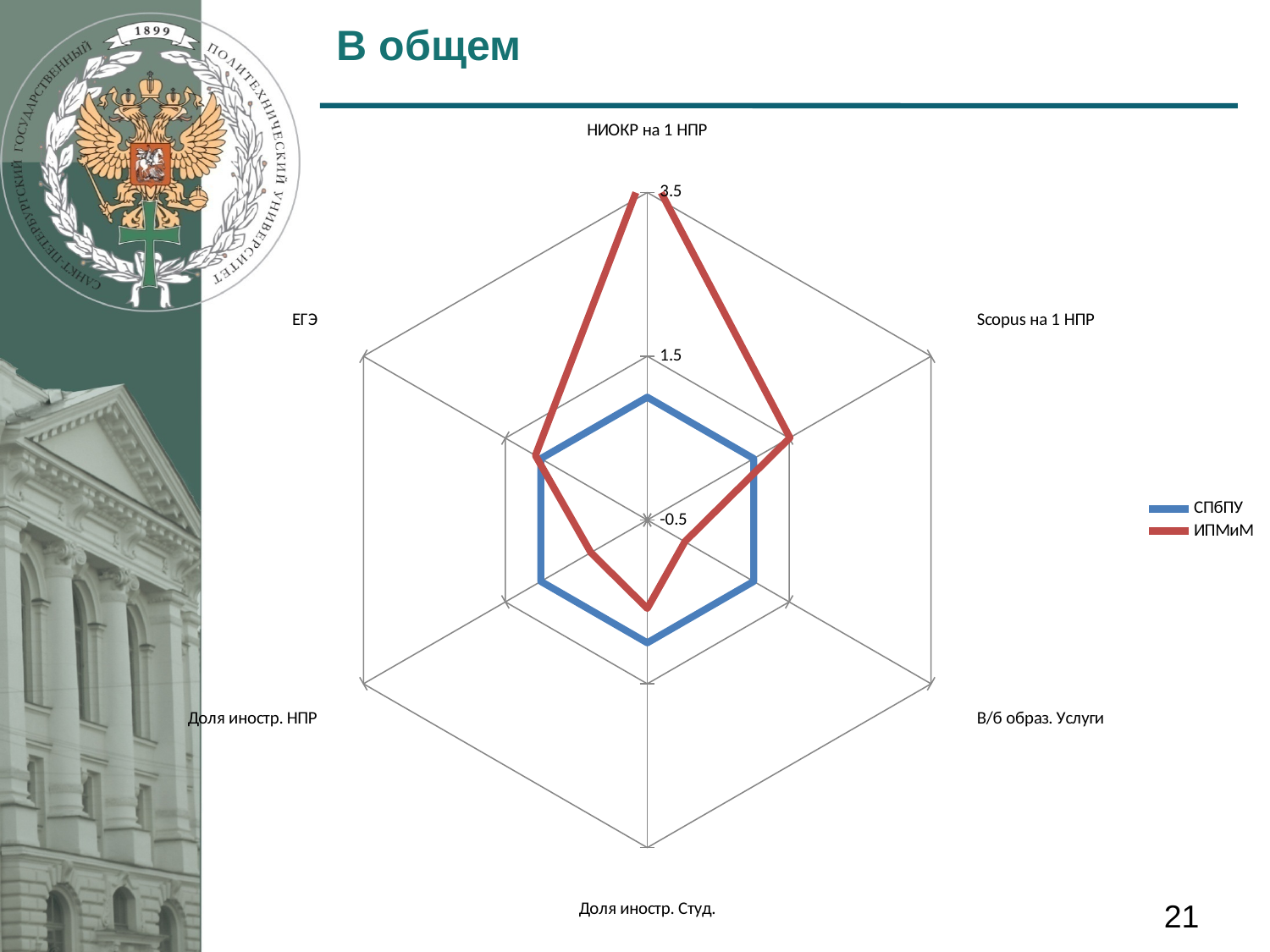
Is the СПбПУ value for НИОКР на 1 НПР greater or less than 1.5? less On which axis does the ИПМиМ series reach its highest value? НИОКР на 1 НПР Which series is drawn in red? ИПМиМ Which series has the larger value for Доля иностр. Студ., СПбПУ or ИПМиМ? СПбПУ Which series has the larger value for В/б образ. Услуги, СПбПУ or ИПМиМ? СПбПУ Which series has the larger value for НИОКР на 1 НПР, СПбПУ or ИПМиМ? ИПМиМ How many series does the legend list? 2 What kind of chart is shown on the slide? radar chart Which series is drawn in blue? СПбПУ Is the ИПМиМ value for В/б образ. Услуги greater or less than 1.5? less How many axes (categories) does the radar chart have? 6 Is the ИПМиМ value for НИОКР на 1 НПР greater or less than 1.5? greater